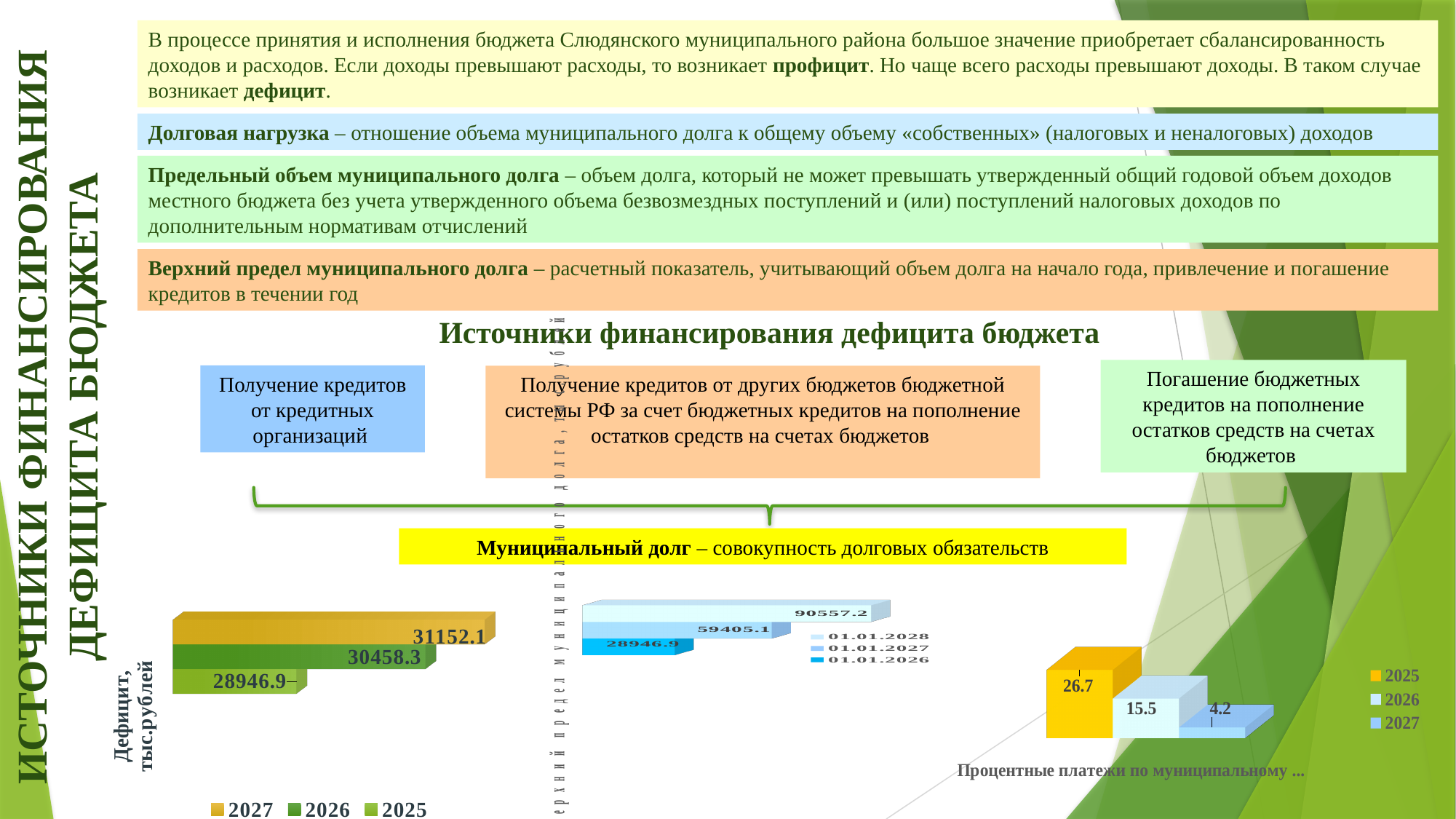
In the left chart (Дефицит, тыс.рублей), what is the value for 2025? 28946.9 In the right chart (Процентные платежи по муниципальному ...), do the values rise or fall from 2025 to 2027? fall In the middle chart, what is the difference between the values for 01.01.2028 and 01.01.2027? 31152.1 In the left chart (Дефицит, тыс.рублей), which year has the highest value? 2027 In the right chart (Процентные платежи по муниципальному ...), which is larger, the value for 2026 or the value for 2027? 2026 In the right chart (Процентные платежи по муниципальному ...), what is the value for 2025? 26.7 In the middle chart, what is the value for 01.01.2028? 90557.2 In the left chart (Дефицит, тыс.рублей), what is the difference between the 2027 and 2026 values? 693.8 In the middle chart, what is the value for 01.01.2027? 59405.1 In the left chart (Дефицит, тыс.рублей), how many series does the legend list? 3 In the middle chart, which date has the lowest value? 01.01.2026 In the left chart (Дефицит, тыс.рублей), what is the value for 2027? 31152.1